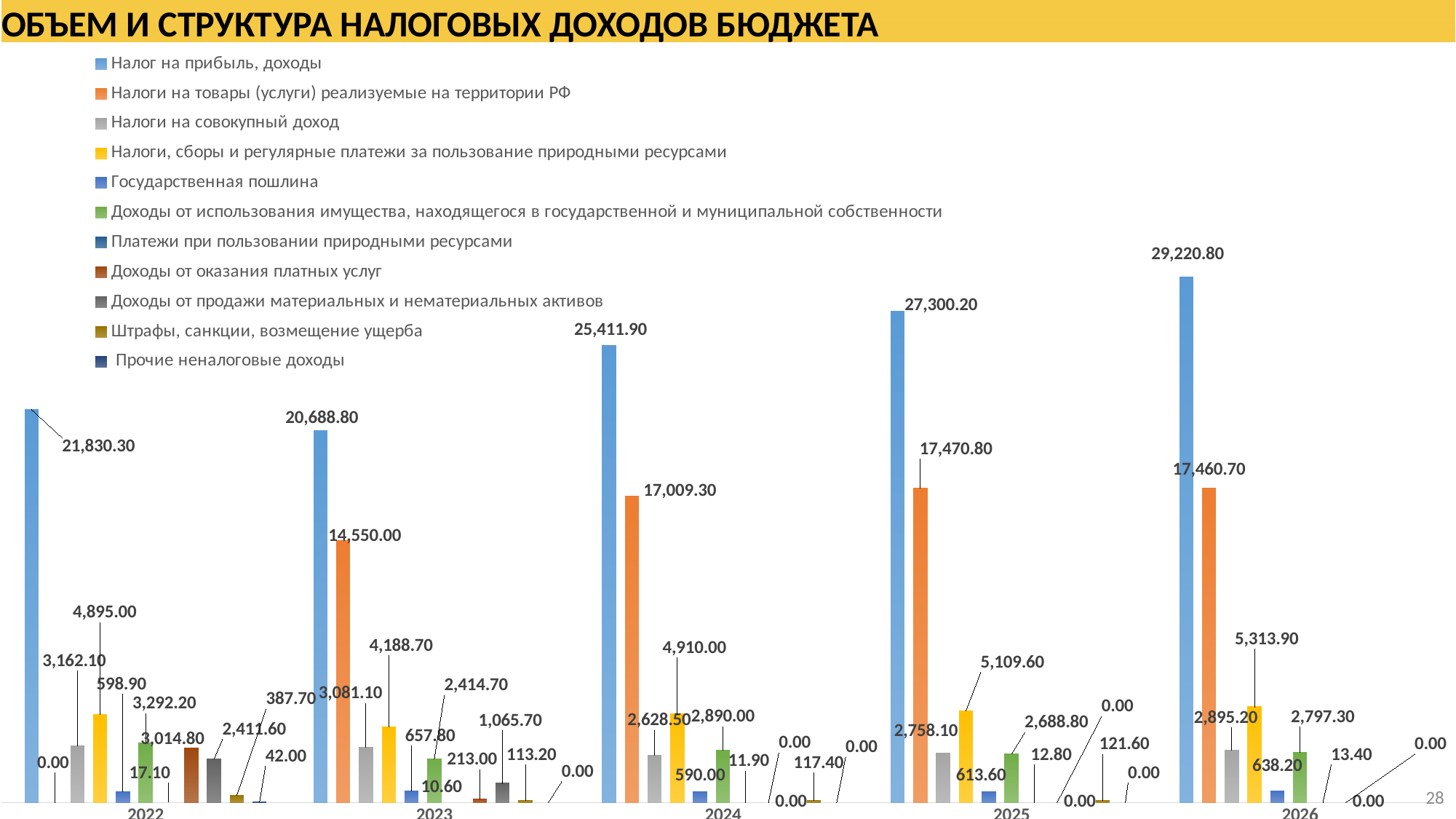
In which year is Налог на прибыль, доходы the highest? 2026 Which is larger in 2025: Налог на прибыль, доходы or Налоги на товары (услуги) реализуемые на территории РФ? Налог на прибыль, доходы What is the value of Налоги на товары (услуги) реализуемые на территории РФ for 2023? 14,550.00 How many years are shown on the x axis? 5 What kind of chart is shown on the slide? Bar chart How many series does the legend list? 11 What is the value of Налог на прибыль, доходы for 2024? 25,411.90 What is the difference between Налоги на товары (услуги) реализуемые на территории РФ in 2024 and in 2023? 2,459.30 What is the value of Налоги, сборы и регулярные платежи за пользование природными ресурсами for 2026? 5,313.90 In which year is Налог на прибыль, доходы the lowest? 2023 What is the value of Налог на прибыль, доходы for 2026? 29,220.80 What is the difference between Налог на прибыль, доходы in 2026 and in 2025? 1,920.60